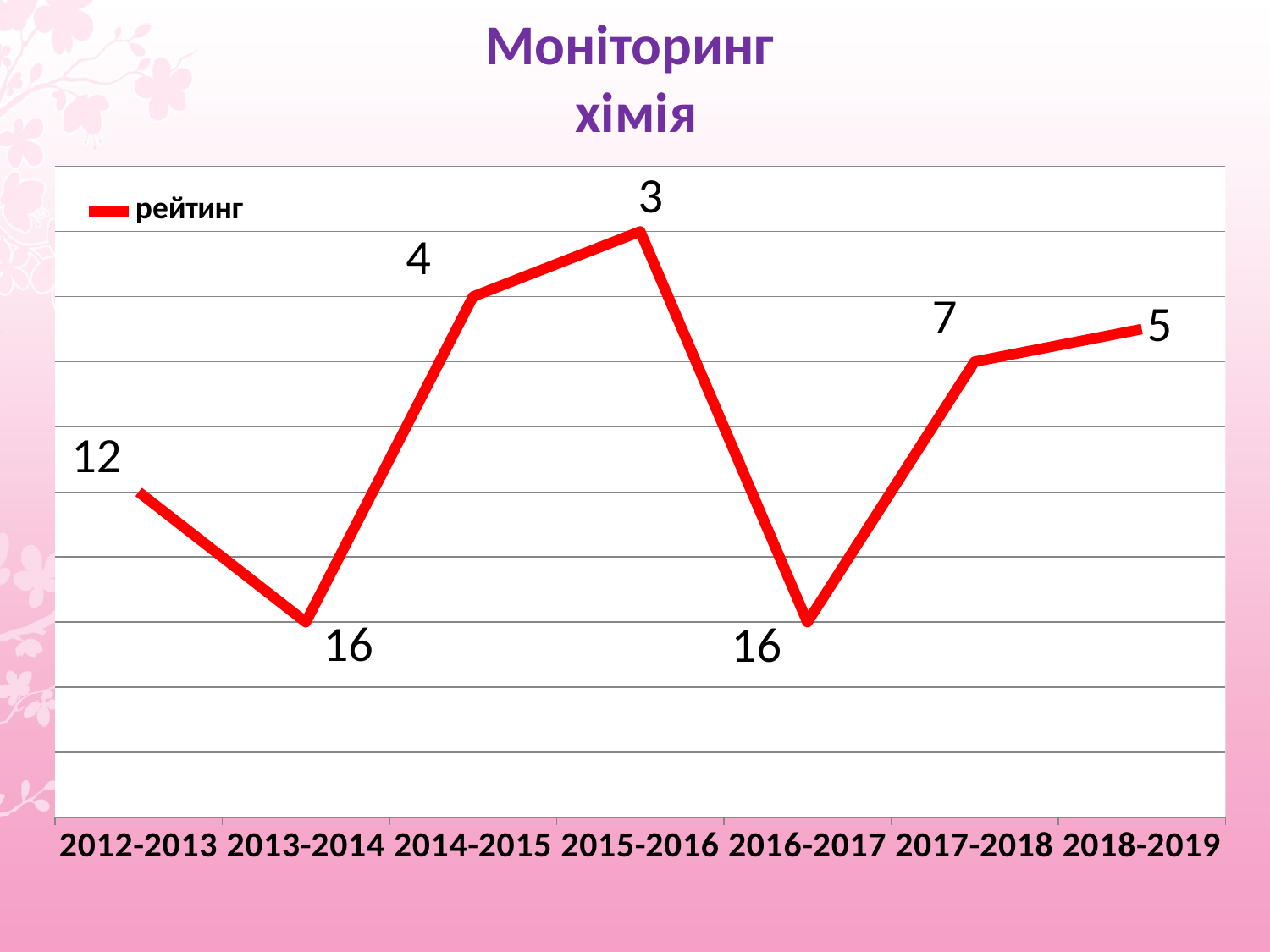
What is the difference between the values for 2016-2017 and 2015-2016? 13 What is the value for 2018-2019? 5 What is the value for 2015-2016? 3 What is the name of the series in the legend? рейтинг What is the largest value plotted on the chart? 16 How many years are shown on the x axis? 7 What type of chart is shown on the slide? line chart Which year has the smallest value? 2015-2016 Which is larger, the value for 2014-2015 or the value for 2017-2018? 2017-2018 What is the value for 2017-2018? 7 What is the value for 2012-2013? 12 What is the difference between the values for 2013-2014 and 2012-2013? 4